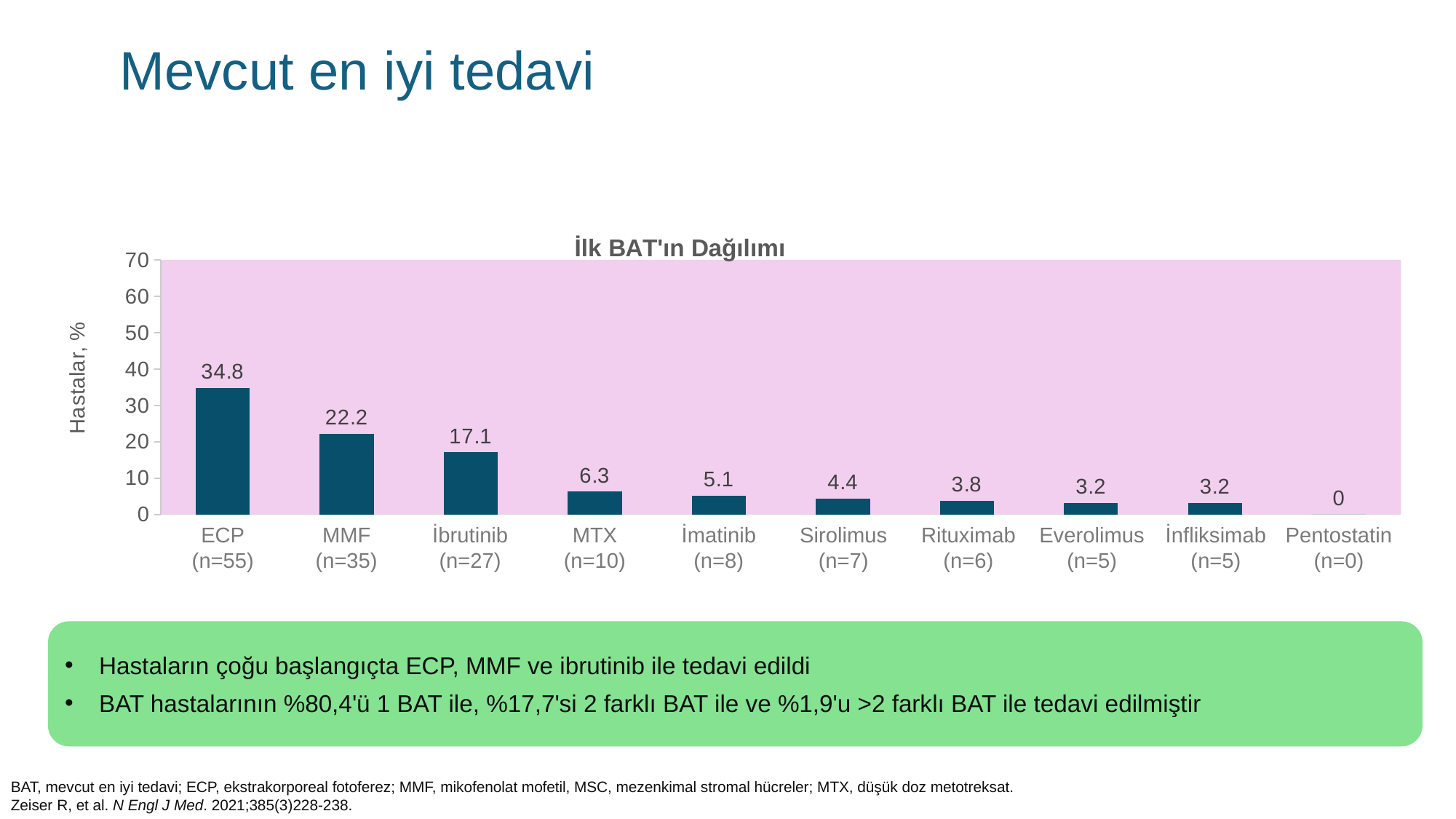
What is the value for ECP (n=55)? 34.8 Which category has the highest value? ECP (n=55) Do the values rise or fall from left to right along the x axis? fall Which is larger, the value for MTX (n=10) or the value for İmatinib (n=8)? MTX (n=10) Is the value for MMF (n=35) greater or less than 20? greater What is the difference between the values for ECP (n=55) and MMF (n=35)? 12.6 How many categories are shown on the x axis? 10 What is the title of the chart? İlk BAT'ın Dağılımı What is the value for İbrutinib (n=27)? 17.1 What is the value for Sirolimus (n=7)? 4.4 What kind of chart is this? bar chart Which category has the lowest value? Pentostatin (n=0)